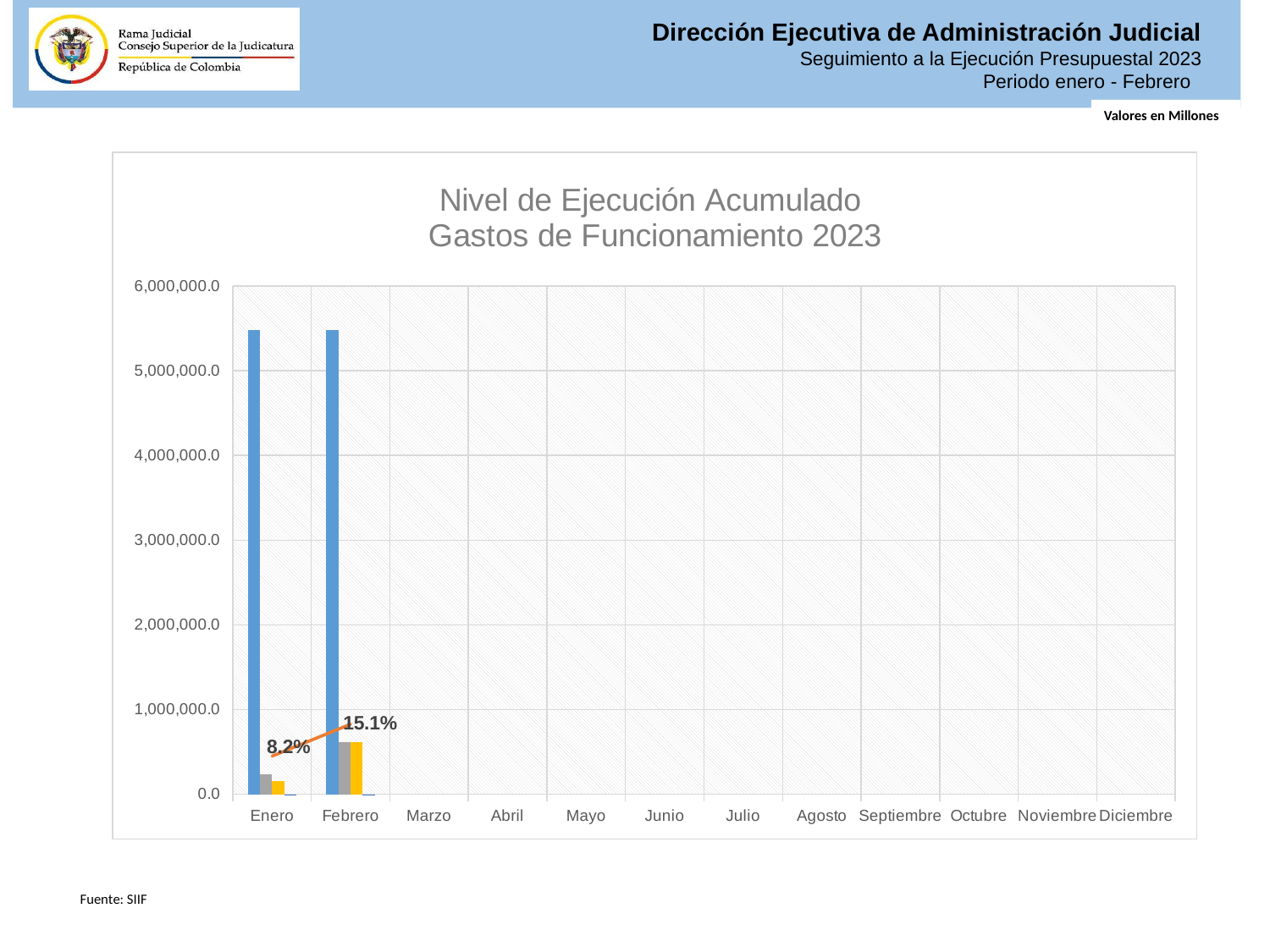
What is the highest value shown on the vertical axis of the chart? 6,000,000.0 Is the value of the yellow bar for Febrero greater or less than 1,000,000.0? less Does the percentage line rise or fall from Enero to Febrero? rise How many months are listed along the x axis of the chart? 12 What is the difference between the percentage labelled for Febrero and the percentage labelled for Enero? 6.9% Is the value of the tallest blue bar for Febrero greater or less than 5,000,000.0? greater What percentage is labelled for Enero on the chart? 8.2% What percentage is labelled for Febrero on the chart? 15.1% What is the title of the chart? Nivel de Ejecución Acumulado Gastos de Funcionamiento 2023 Is the value of the tallest blue bar for Enero greater or less than 5,000,000.0? greater Which month has the higher percentage label, Enero or Febrero? Febrero What kind of chart is shown on the slide? combination bar and line chart